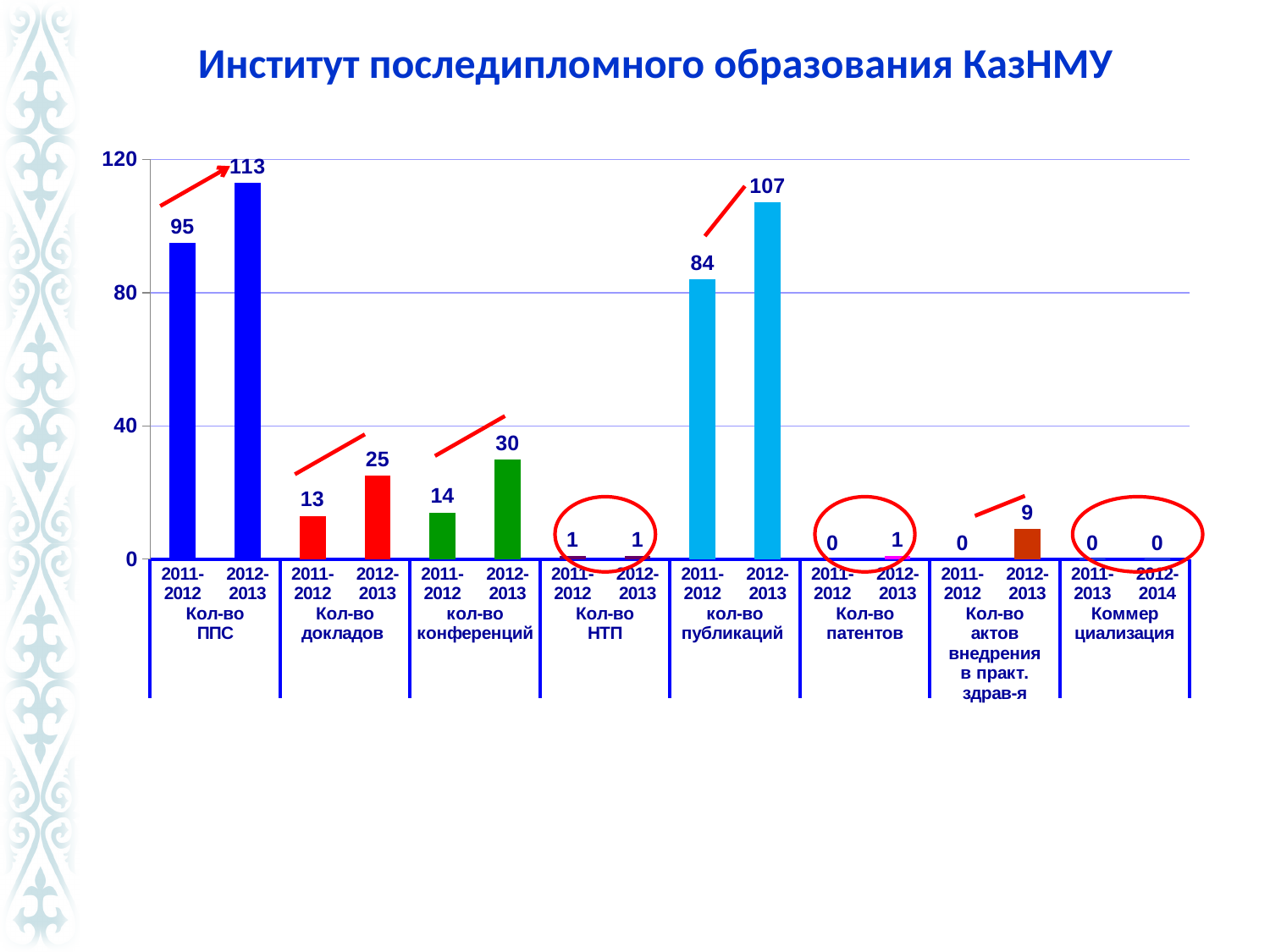
What is the value for Кол-во актов внедрения в практ. здрав-я in 2012-2013? 9 What is the value for кол-во публикаций in 2011-2012? 84 What kind of chart is shown on the slide? bar chart What is the difference between the 2012-2013 and 2011-2012 values for кол-во публикаций? 23 What is the value for Кол-во докладов in 2012-2013? 25 Is the value for Кол-во ППС in 2011-2012 greater or less than 80? greater What is the value for Кол-во ППС in 2012-2013? 113 What is the title of the slide? Институт последипломного образования КазНМУ How many category groups are shown on the x axis? 8 Which bar has the highest value on the chart? Кол-во ППС, 2012-2013 What is the difference between the 2012-2013 and 2011-2012 values for кол-во конференций? 16 Which is larger: Кол-во докладов in 2012-2013 or кол-во конференций in 2012-2013? кол-во конференций in 2012-2013